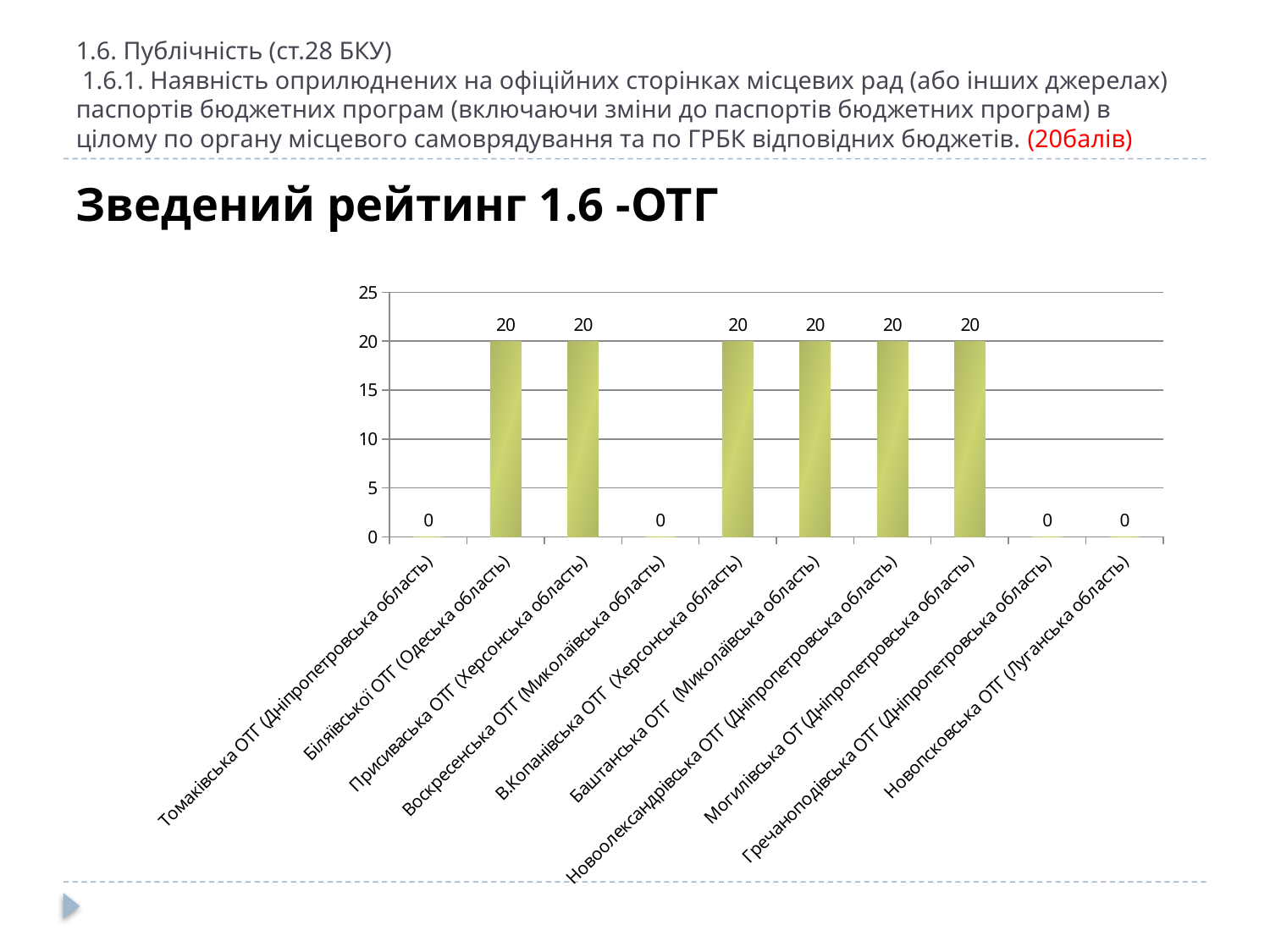
What type of chart is shown on the slide? bar chart How many categories in the chart have a value of 20? 6 What is the value for Біляївської ОТГ (Одеська область)? 20 What is the difference between the values for Присиваська ОТГ (Херсонська область) and Гречаноподівська ОТГ (Дніпропетровська область)? 20 What is the value for Томаківська ОТГ (Дніпропетровська область)? 0 What is the value for Новопсковська ОТГ (Луганська область)? 0 What is the value for Баштанська ОТГ (Миколаївська область)? 20 What is the value for Воскресенська ОТГ (Миколаївська область)? 0 How many categories (ОТГ) are shown on the x axis of the chart? 10 Which is larger: the value for Могилівська ОТ (Дніпропетровська область) or the value for Томаківська ОТГ (Дніпропетровська область)? Могилівська ОТ (Дніпропетровська область) What is the title of the chart section on the slide? Зведений рейтинг 1.6 -ОТГ Is the value for В.Копанівська ОТГ (Херсонська область) greater or less than 15? greater